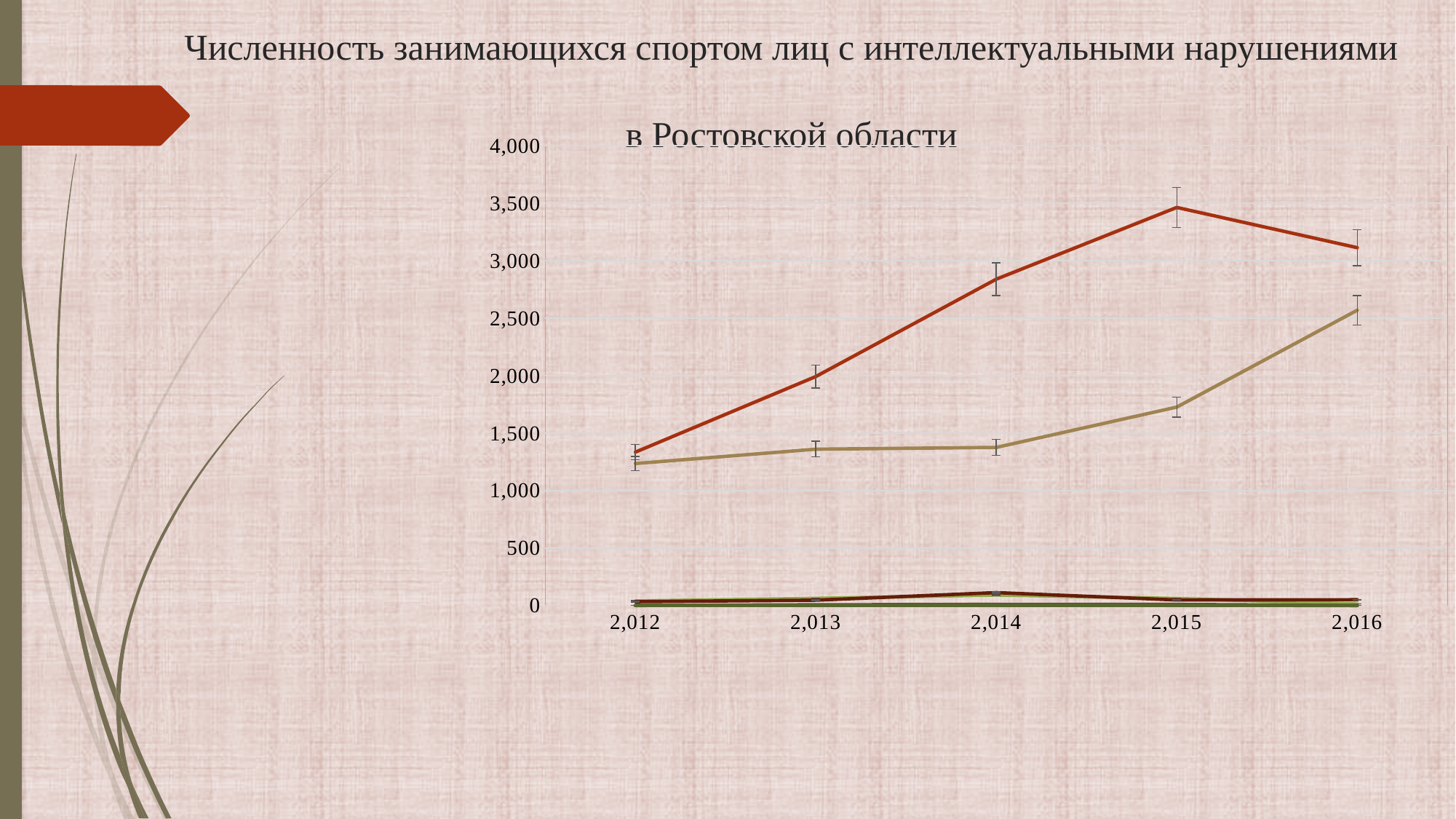
What is the first year shown on the x axis of the chart? 2,012 In which year does the red line have its lowest value? 2,012 What is the highest value shown on the y axis of the chart? 4,000 Is the value of the red line in 2,015 greater or less than 3,000? greater In which year does the red line reach its highest value? 2,015 Is the value of the tan line in 2,016 greater or less than 2,000? greater What kind of chart is shown on the slide? line chart How many years are shown along the x axis of the chart? 5 Is the value of the red line in 2,013 greater or less than 2,500? less Does the tan line rise or fall from 2,012 to 2,016? rise In 2,016, which line has the larger value, the red line or the tan line? the red line